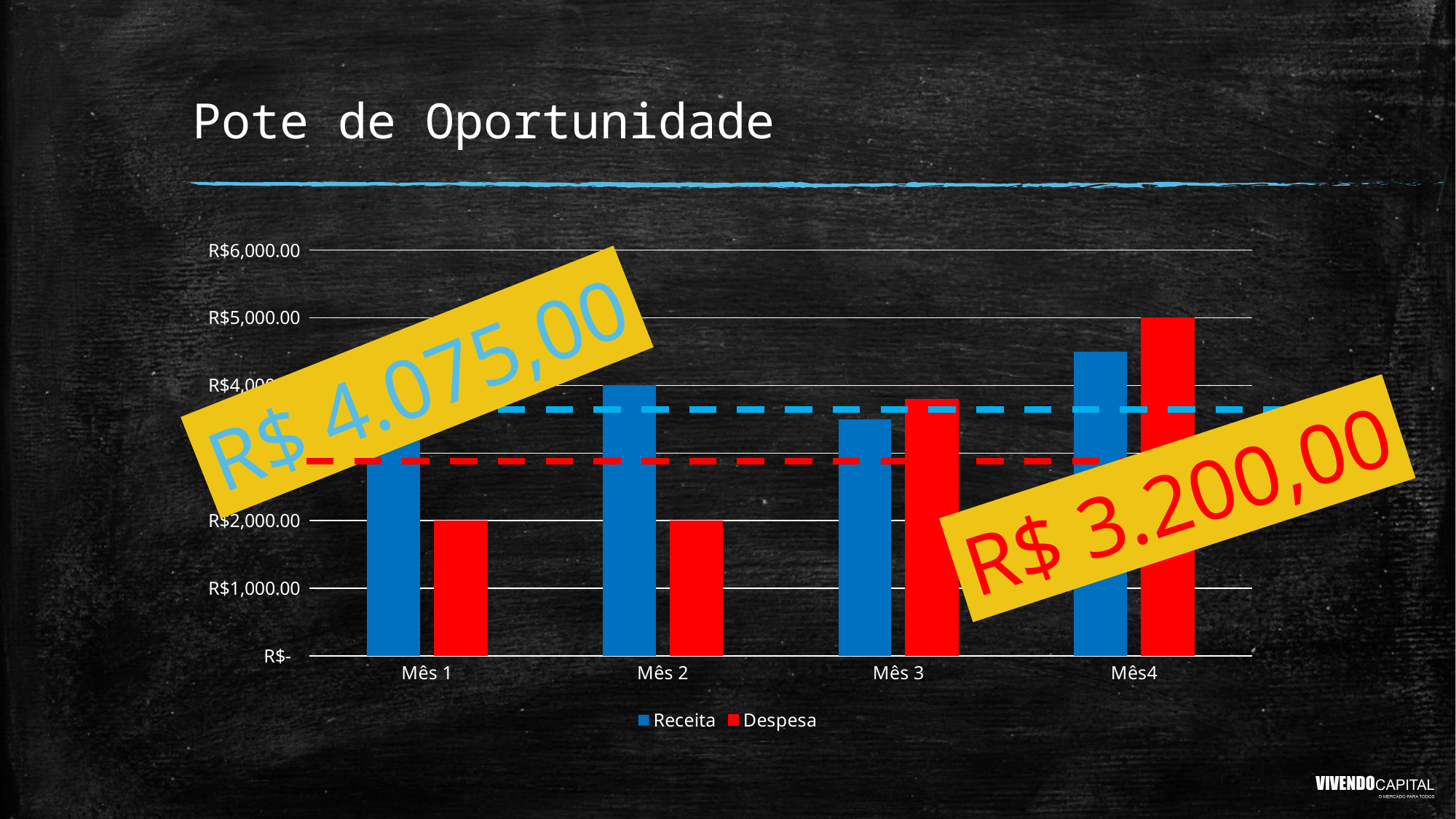
How many series does the legend list? 2 In Mês4, which is larger, Receita or Despesa? Despesa What kind of chart is shown on the slide? bar chart How many categories are shown on the x axis? 4 What is the Despesa value for Mês4? R$5,000.00 What is the difference between Receita and Despesa in Mês 2? R$2,000.00 What is the Despesa value for Mês 1? R$2,000.00 What is the title of the slide? Pote de Oportunidade What is the Receita value for Mês 2? R$4,000.00 Is the Receita value for Mês4 greater or less than R$4,000.00? greater Which month has the highest Despesa? Mês4 Which month has the highest Receita? Mês4